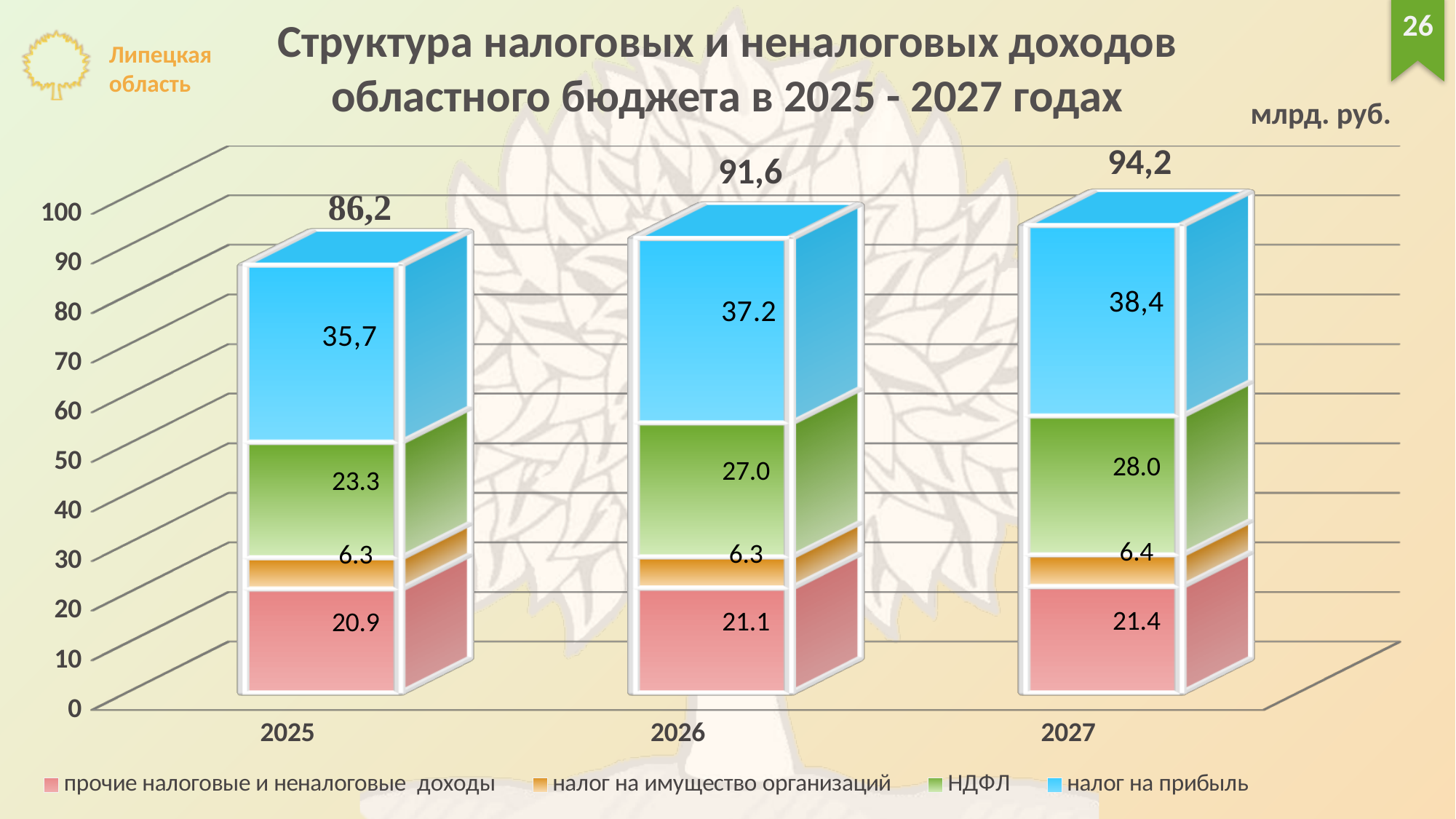
How many series does the legend list? 4 What is the value for налог на прибыль in 2025? 35,7 Which year has the highest total? 2027 Do the bar totals rise or fall from 2025 to 2027? rise How many years are shown on the x axis? 3 Which year has the lowest total? 2025 What is the difference between the НДФЛ values for 2027 and 2025? 4.7 Which is larger: налог на прибыль in 2026 or налог на прибыль in 2027? 2027 What is the total of the stacked bar for 2027? 94,2 What is the value for налог на имущество организаций in 2027? 6.4 What is the value for НДФЛ in 2026? 27.0 What is the value for прочие налоговые и неналоговые доходы in 2025? 20.9